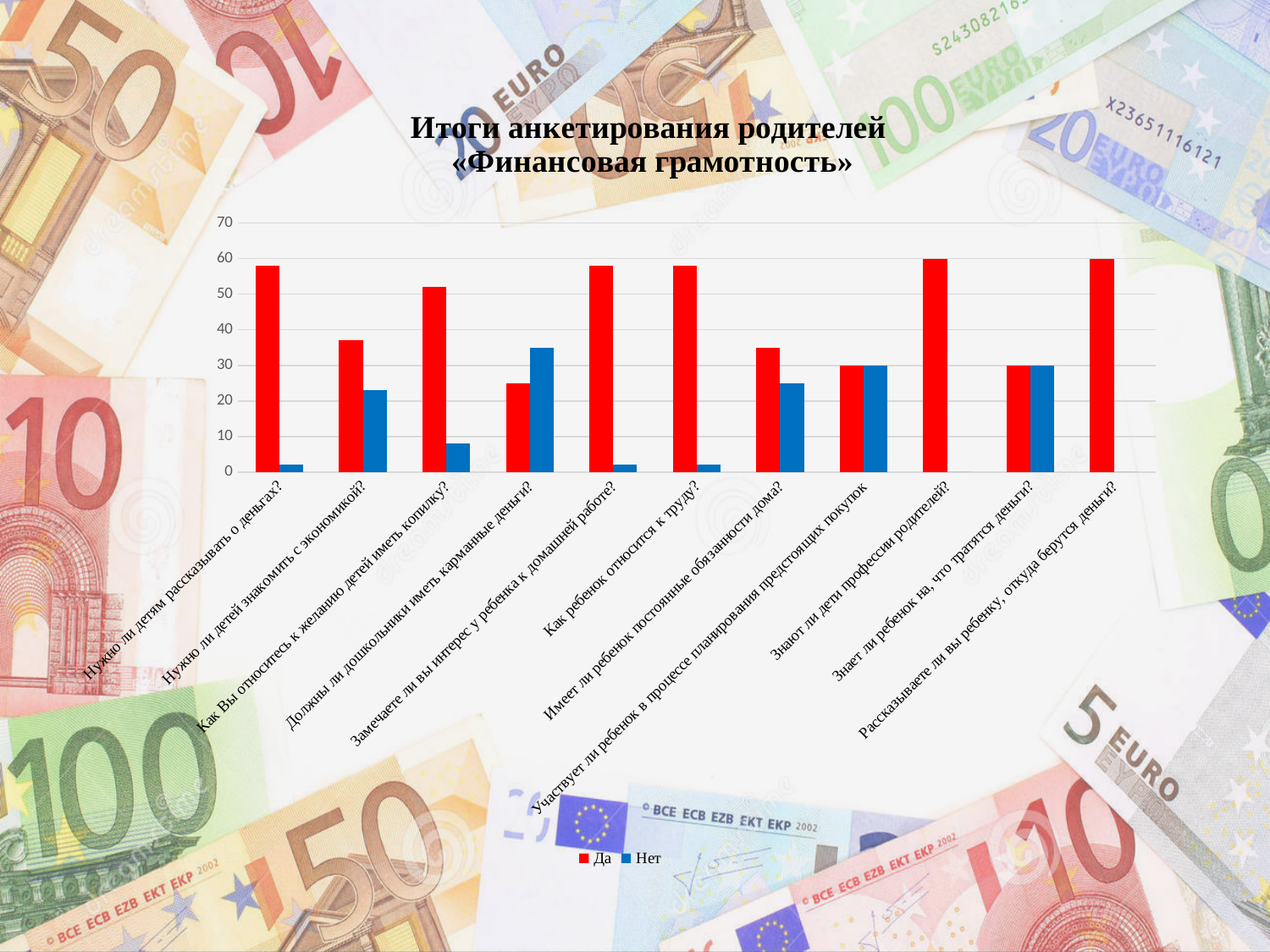
What kind of chart is shown on the slide? bar chart How many question categories are shown on the x axis? 11 Which series is shown in red? Да Is the value for "Нет" for "Имеет ли ребенок постоянные обязанности дома?" greater or less than 20? greater Is the value for "Да" for "Нужно ли детям рассказывать о деньгах?" greater or less than 50? greater Is the value for "Нет" for "Нужно ли детям рассказывать о деньгах?" greater or less than 10? less How many series does the legend list? 2 For "Должны ли дошкольники иметь карманные деньги?", which is larger, "Да" or "Нет"? Нет For "Как Вы относитесь к желанию детей иметь копилку?", which is larger, "Да" or "Нет"? Да Which category has the lowest "Да" value? Должны ли дошкольники иметь карманные деньги?